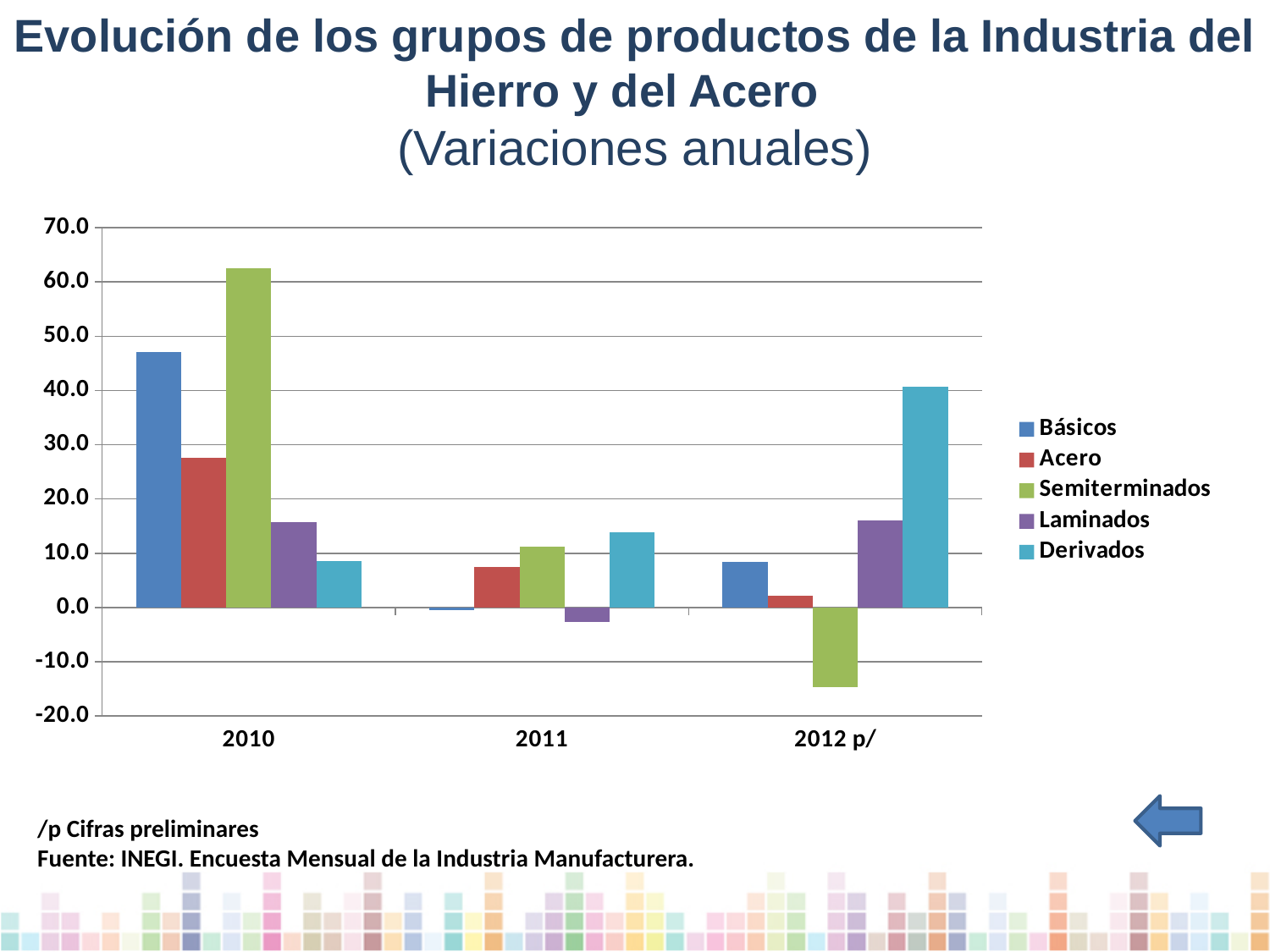
What kind of chart is shown on the slide? bar chart How many series does the legend list? 5 In 2010, which is larger: the value for Básicos or the value for Acero? Básicos Which product group has the lowest value in 2012 p/? Semiterminados Is the value for Semiterminados in 2012 p/ greater or less than -10.0? less How many year categories are shown on the x axis? 3 Which product group has the highest value in 2012 p/? Derivados Is the value for Semiterminados in 2010 greater or less than 50.0? greater Is the value for Derivados in 2012 p/ greater or less than 30.0? greater Which series is shown in light blue in the legend? Derivados Which product group has the highest value in 2010? Semiterminados Do the values for Semiterminados rise or fall from 2010 to 2012 p/? fall